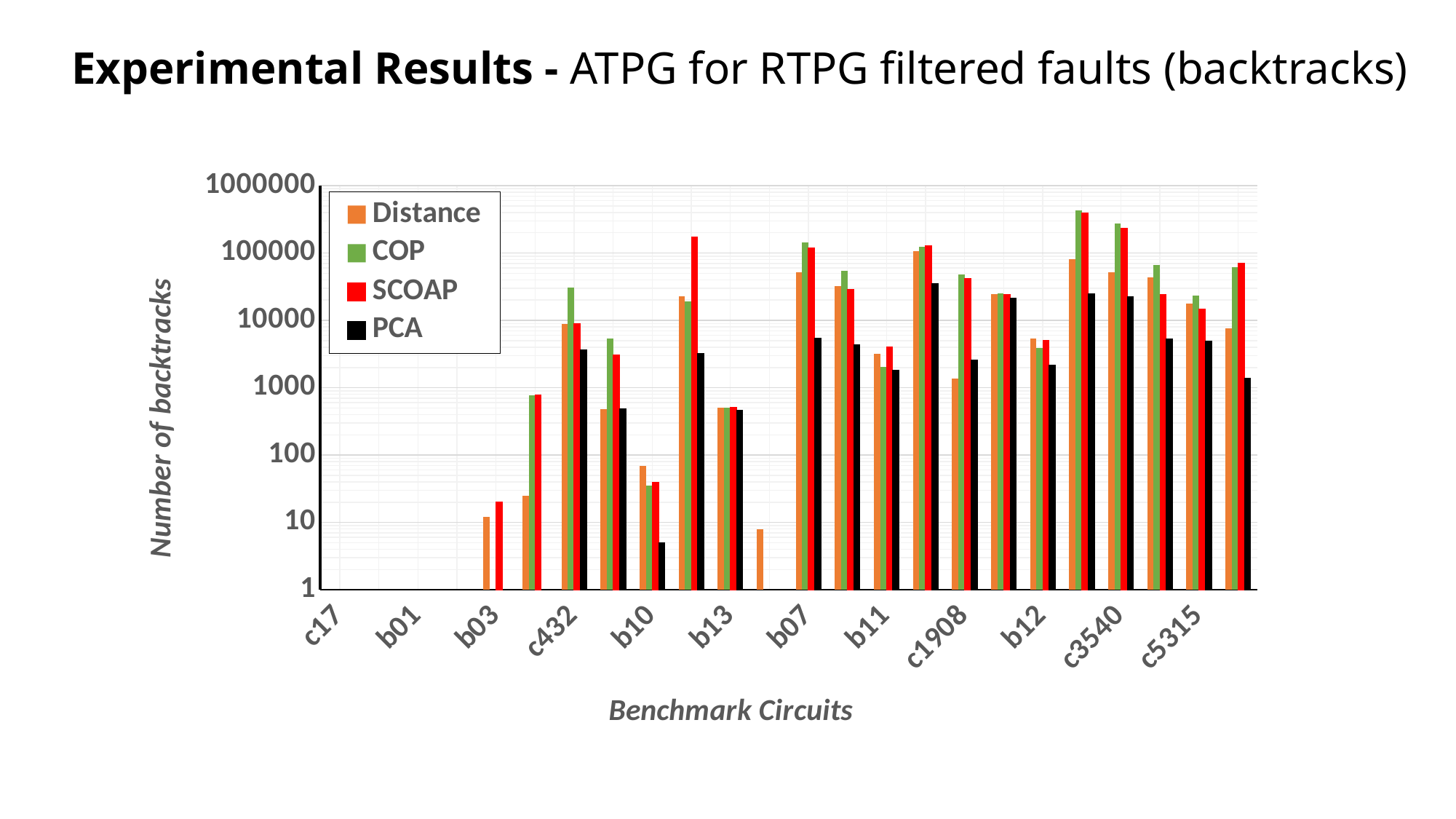
What is the label of the vertical axis? Number of backtracks Which series has the lowest value for b10? PCA Is the PCA value for b07 greater or less than 10000? less What kind of chart is shown on the slide? bar chart Is the Distance value for c1908 greater or less than 10000? less How many series does the legend list? 4 Is the COP value for c3540 greater or less than 100000? greater What is the title of the chart on the slide? Experimental Results - ATPG for RTPG filtered faults (backtracks) For b07, which is larger, the Distance value or the PCA value? Distance For c3540, which is larger, the COP value or the PCA value? COP